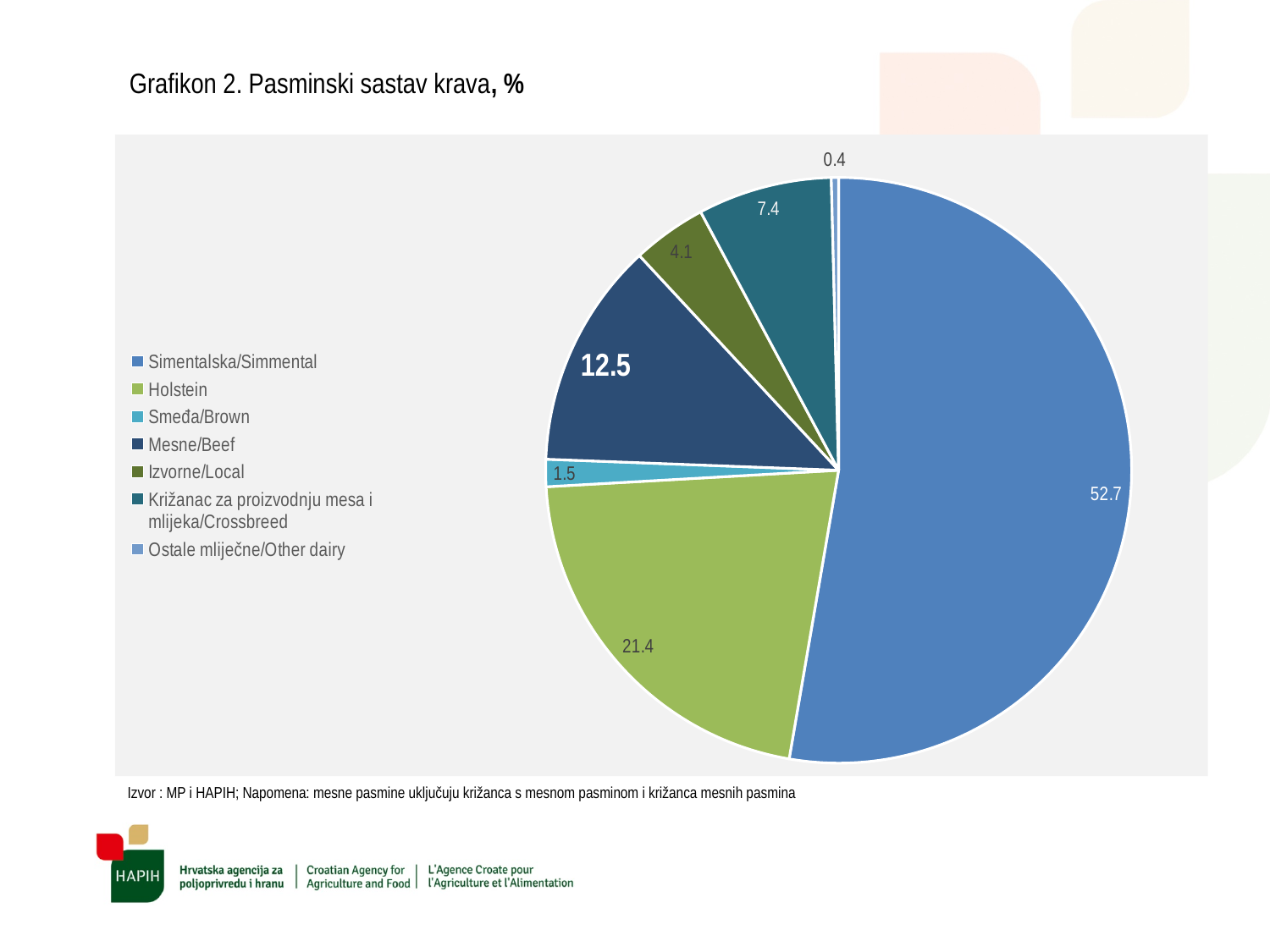
Which category has the smallest share of the pie? Ostale mliječne/Other dairy What is the value for Holstein? 21.4 Which is larger, the value for Mesne/Beef or the value for Križanac za proizvodnju mesa i mlijeka/Crossbreed? Mesne/Beef What is the title of the chart? Grafikon 2. Pasminski sastav krava, % What is the value for Križanac za proizvodnju mesa i mlijeka/Crossbreed? 7.4 What is the value for Simentalska/Simmental? 52.7 What is the difference between the values for Simentalska/Simmental and Holstein? 31.3 Which category has the largest share of the pie? Simentalska/Simmental What kind of chart is shown on the slide? Pie chart What is the value for Mesne/Beef? 12.5 What is the value for Izvorne/Local? 4.1 How many categories does the legend list? 7